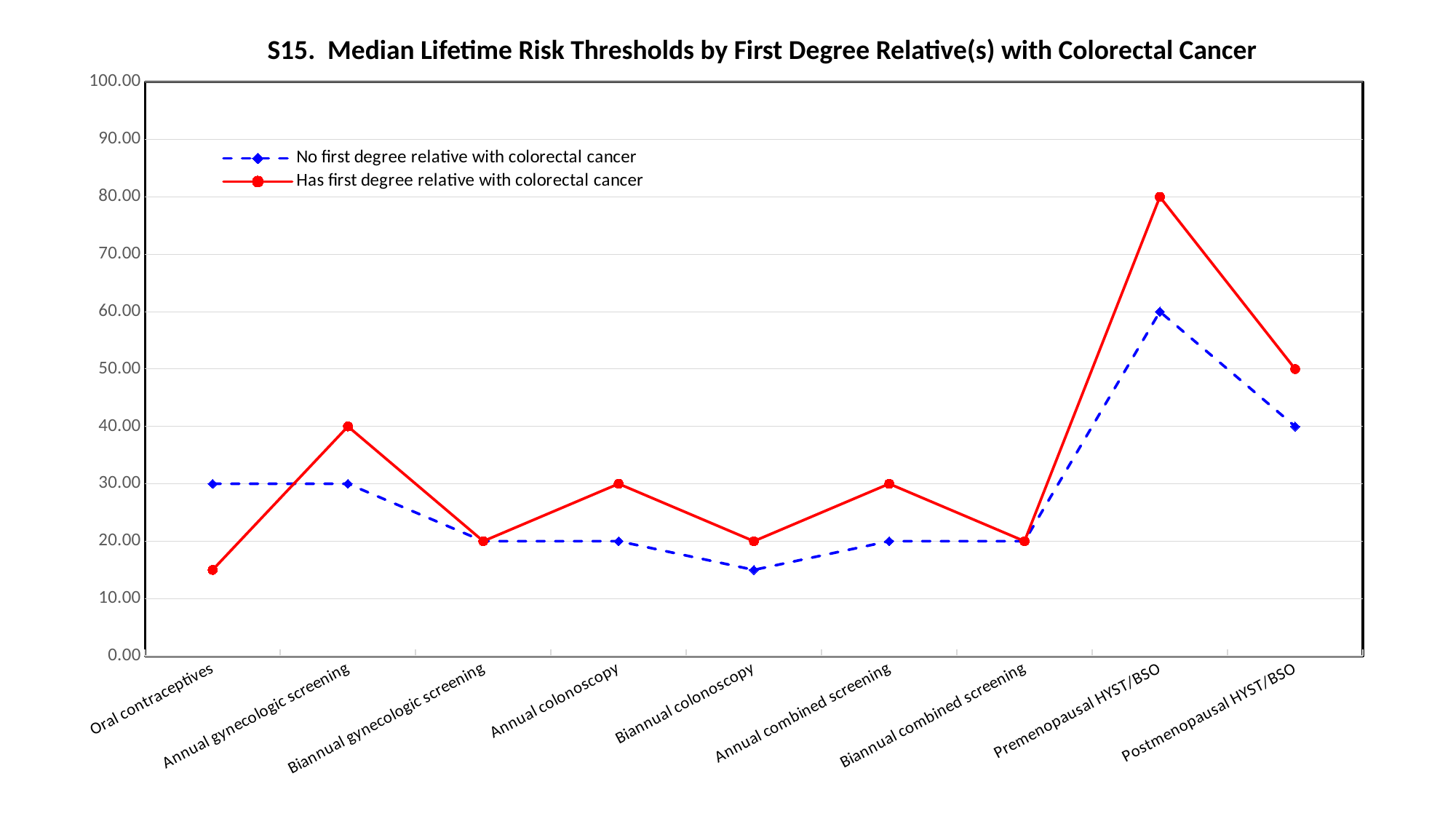
How many series does the legend list? 2 Which category has the highest value in the 'Has first degree relative with colorectal cancer' series? Premenopausal HYST/BSO Which category has the lowest value in the 'No first degree relative with colorectal cancer' series? Biannual colonoscopy How many categories are shown on the x axis? 9 What is the value for Annual gynecologic screening in the 'Has first degree relative with colorectal cancer' series? 40.00 What type of chart is shown on the slide? line chart What is the value for Premenopausal HYST/BSO in the 'Has first degree relative with colorectal cancer' series? 80.00 Is the value for Oral contraceptives in the 'Has first degree relative with colorectal cancer' series greater or less than 20.00? less What is the difference between the two series at Postmenopausal HYST/BSO? 10.00 What is the value for Premenopausal HYST/BSO in the 'No first degree relative with colorectal cancer' series? 60.00 Which series is drawn with a dashed blue line? No first degree relative with colorectal cancer At Oral contraceptives, which series has the larger value? No first degree relative with colorectal cancer